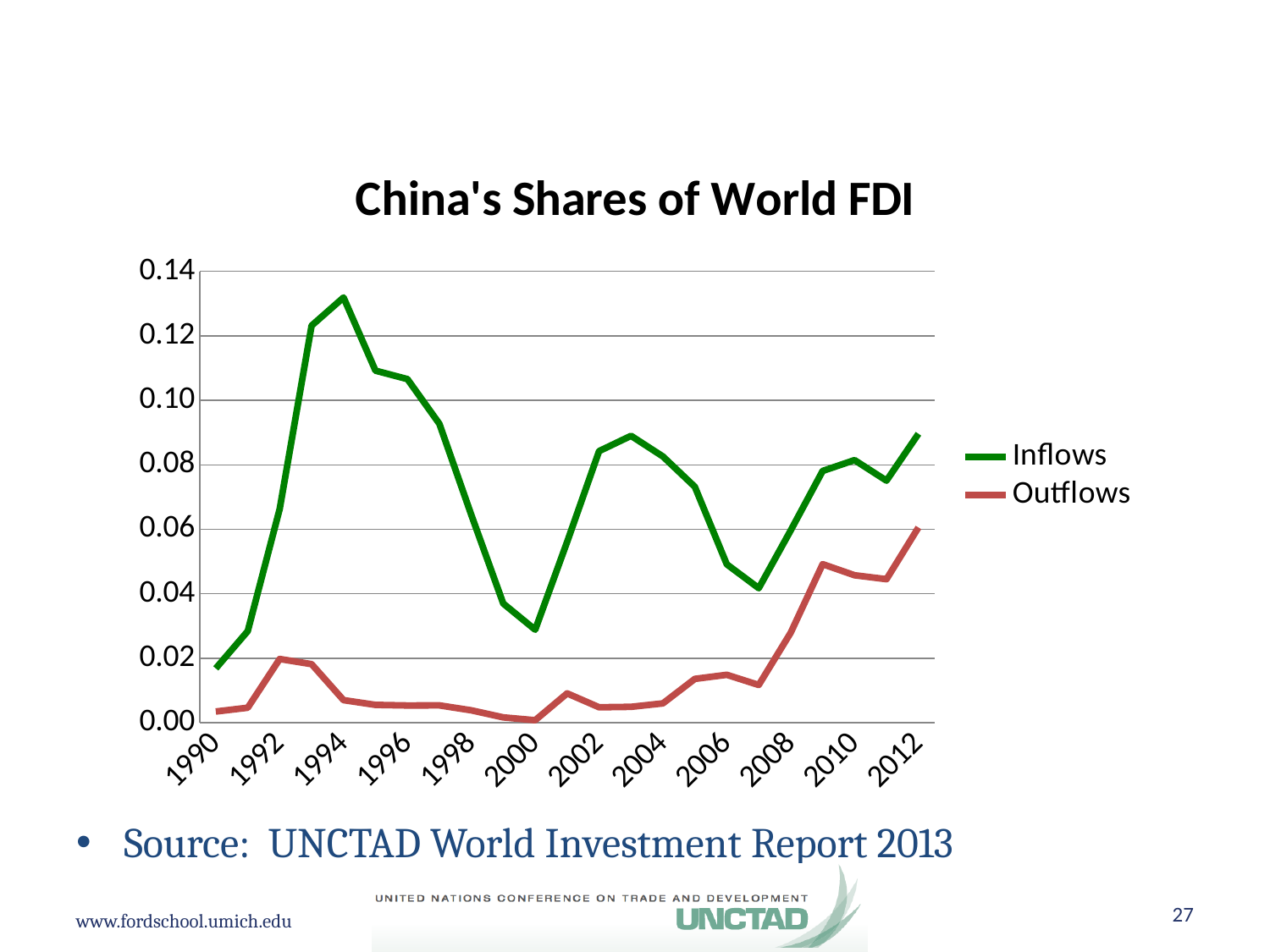
Is the Inflows value for 2000 greater or less than 0.04? less Is the Inflows value for 1994 greater or less than 0.12? greater What is the title of the chart? China's Shares of World FDI Which series is drawn in green? Inflows What kind of chart is shown on the slide? line chart Do the Outflows values rise or fall from 2008 to 2012? rise How many years are labeled on the x axis? 12 In which year does the Outflows series reach its highest value? 2012 Is the Outflows value for 2000 greater or less than 0.02? less Which series has the larger value in 1994, Inflows or Outflows? Inflows In which year does the Inflows series reach its highest value? 1994 How many series does the legend list? 2